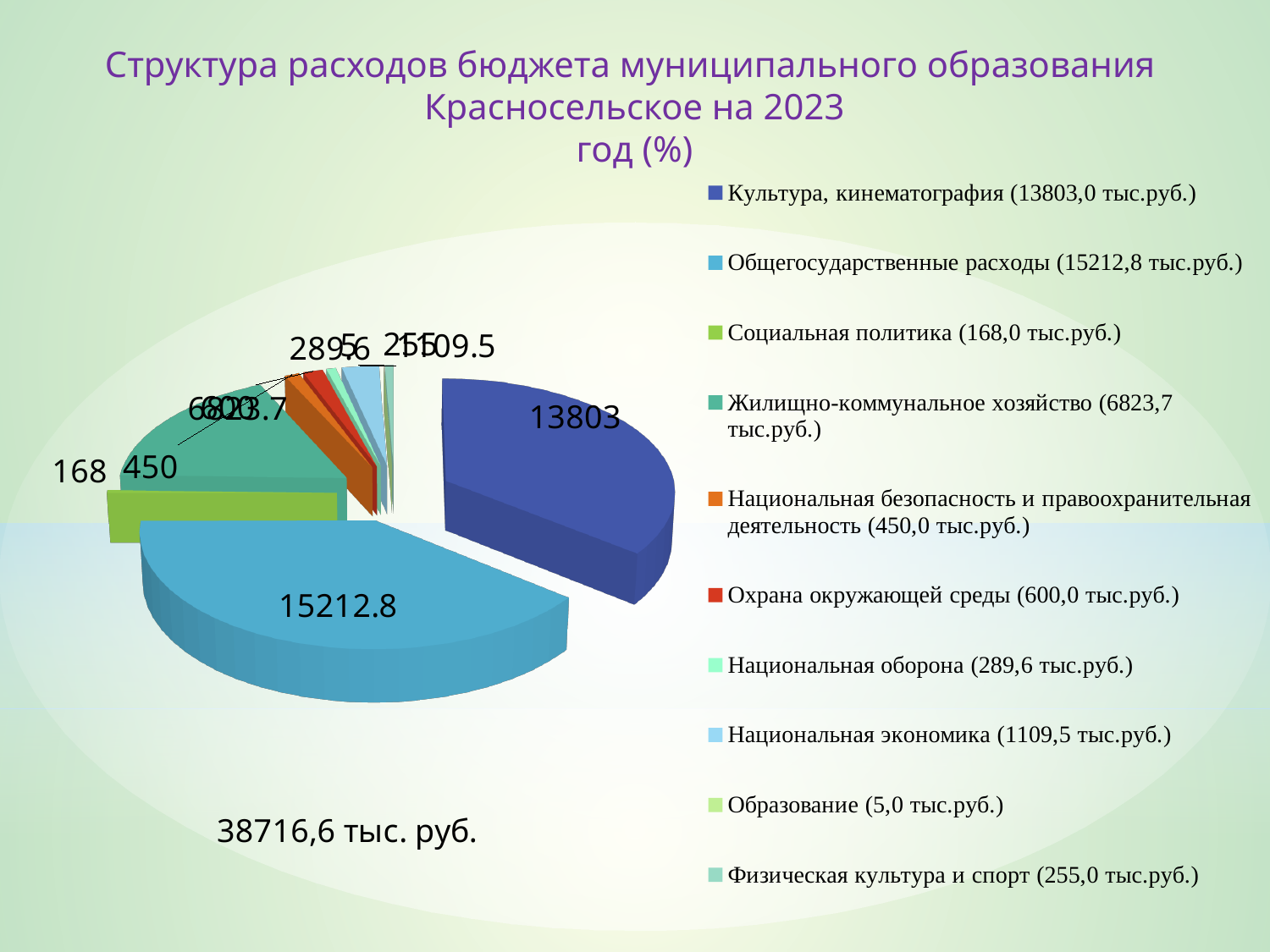
What total amount is printed below the pie chart? 38716,6 тыс. руб. What value is labelled on the slice for Общегосударственные расходы? 15212.8 What is the difference between the values for Общегосударственные расходы and Культура, кинематография? 1409.8 What kind of chart is shown on the slide? pie chart Which category has the smallest value in the chart? Образование How many entries does the legend list? 10 What value is labelled on the slice for Социальная политика? 168 How many categories (slices) does the pie chart have? 10 What is the difference between the values for Охрана окружающей среды and Национальная безопасность и правоохранительная деятельность? 150 What value is labelled on the slice for Культура, кинематография? 13803 Which is larger: the value for Жилищно-коммунальное хозяйство or for Национальная экономика? Жилищно-коммунальное хозяйство Which category has the largest slice of the pie? Общегосударственные расходы